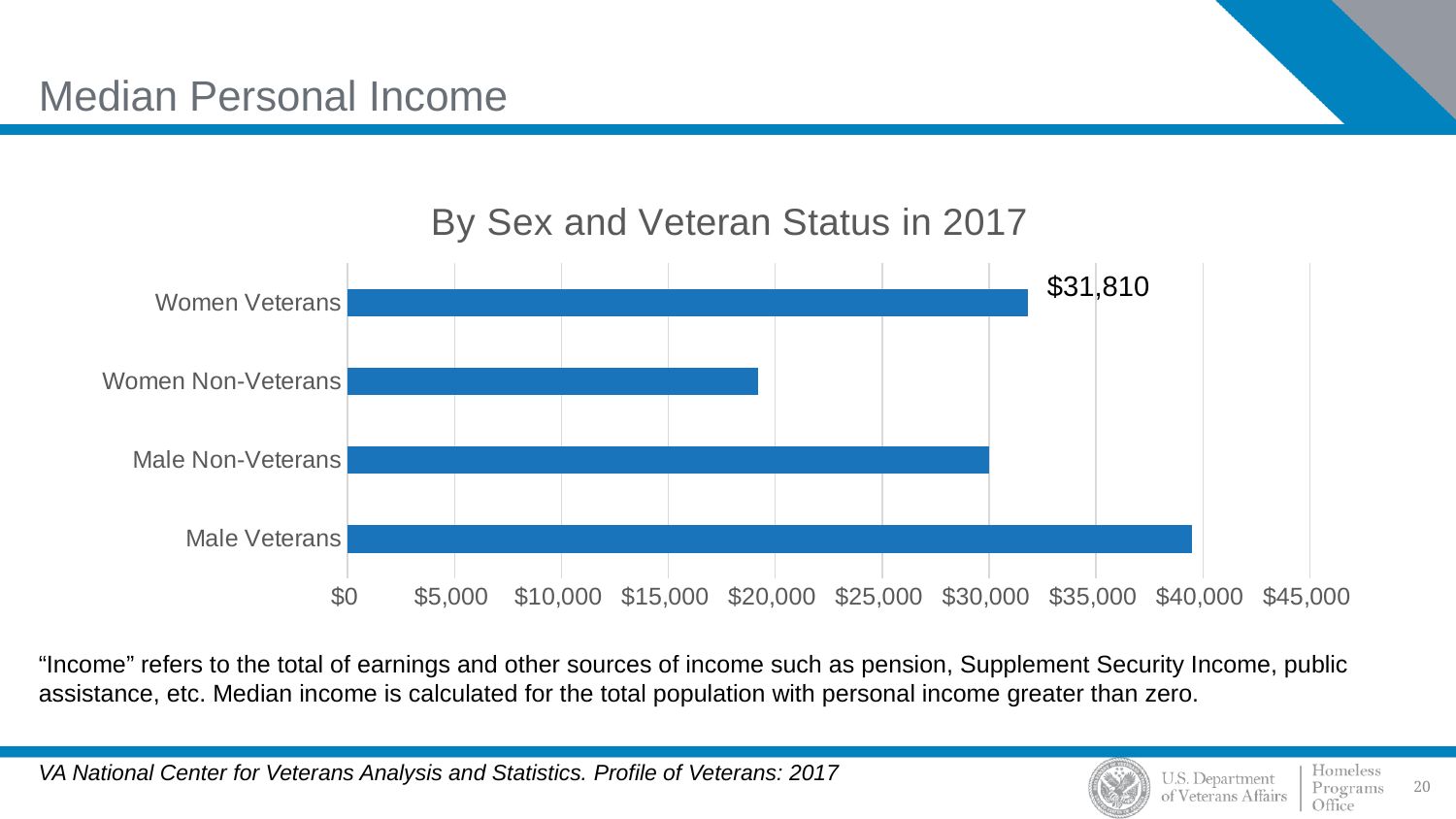
Is the value for Male Non-Veterans greater or less than $25,000? greater Is the value for Male Veterans greater or less than $35,000? greater Which is larger, the median personal income for Male Veterans or for Male Non-Veterans? Male Veterans What kind of chart is shown on the slide? Bar chart Which category has the lowest median personal income? Women Non-Veterans Which category has the highest median personal income? Male Veterans Which is larger, the median personal income for Women Veterans or for Women Non-Veterans? Women Veterans Is the value for Women Non-Veterans greater or less than $20,000? less How many categories are shown in the chart? 4 What is the median personal income for Women Veterans? $31,810 What is the title of the chart? By Sex and Veteran Status in 2017